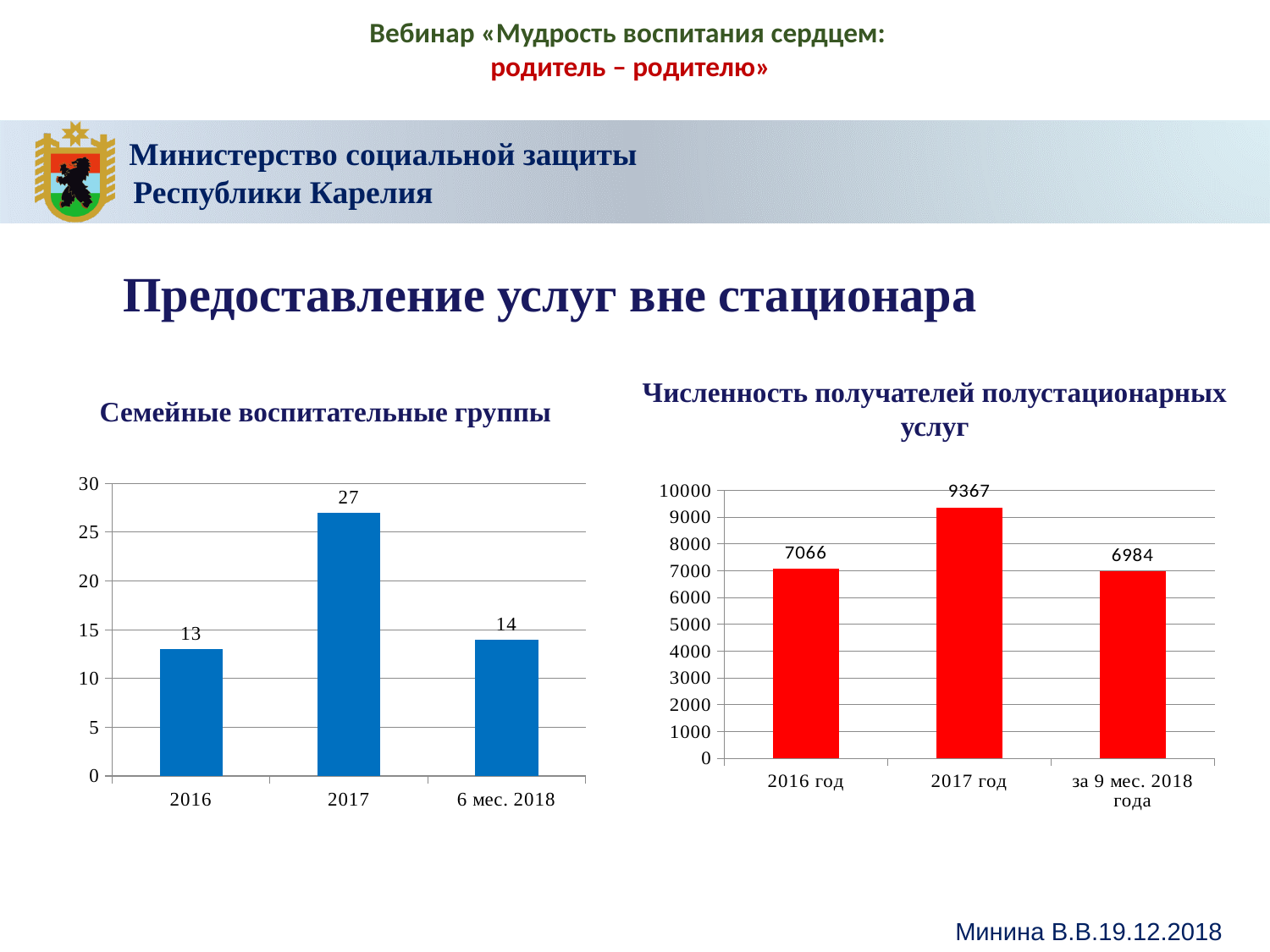
In the chart 'Семейные воспитательные группы', which category has the lowest value? 2016 In the chart 'Численность получателей полустационарных услуг', what is the value for 2016 год? 7066 In the chart 'Численность получателей полустационарных услуг', what is the difference between the values for 2017 год and 2016 год? 2301 In the chart 'Численность получателей полустационарных услуг', which is larger: the value for 2016 год or the value for за 9 мес. 2018 года? 2016 год In the chart 'Семейные воспитательные группы', what is the value for 2017? 27 In the chart 'Численность получателей полустационарных услуг', what is the value for за 9 мес. 2018 года? 6984 What type of chart is 'Численность получателей полустационарных услуг'? Bar chart What colour are the bars in the chart 'Семейные воспитательные группы'? Blue In the chart 'Семейные воспитательные группы', what is the value for 6 мес. 2018? 14 In the chart 'Семейные воспитательные группы', what is the difference between the values for 2017 and 2016? 14 In the chart 'Численность получателей полустационарных услуг', which category has the highest value? 2017 год In the chart 'Семейные воспитательные группы', how many bars are plotted? 3